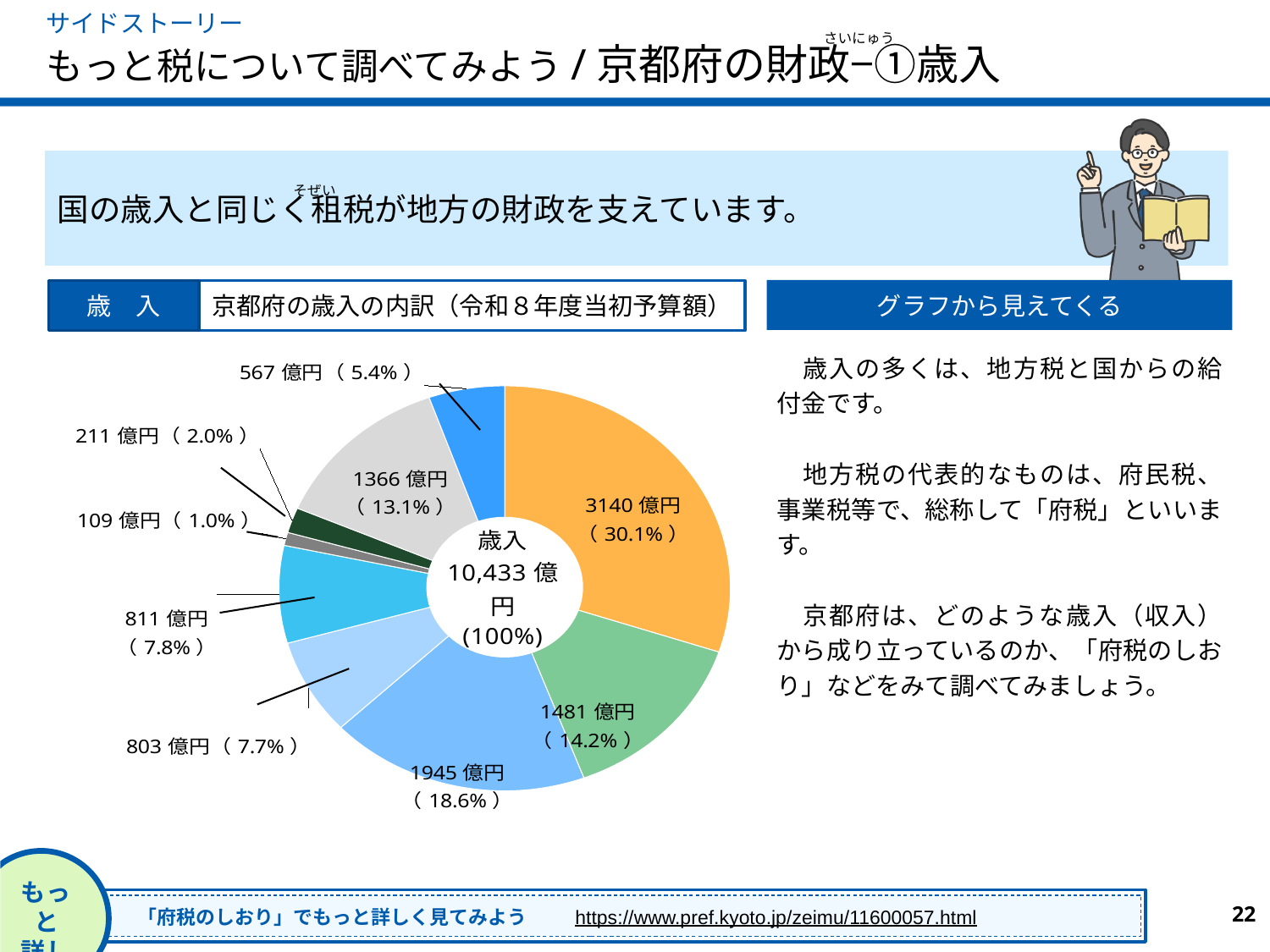
What kind of chart is shown on the slide? Pie chart What share of the pie does the largest slice (3140 億円) represent? 30.1% What total value is printed in the centre of the pie chart? 10,433 億円 What is the value of the smallest slice of the pie chart? 109 億円 How many slices does the pie chart have? 9 What percentage is shown for the 567 億円 slice? 5.4% What is the difference between the largest slice (3140 億円) and the 1945 億円 slice? 1195 億円 What is the value of the largest slice of the pie chart? 3140 億円 What is the difference between the 811 億円 slice and the 803 億円 slice? 8 億円 What is the title of the pie chart? 京都府の歳入の内訳（令和８年度当初予算額） Which slice is larger: the 1481 億円 slice or the 1366 億円 slice? 1481 億円 What share of the pie does the smallest slice (109 億円) represent? 1.0%